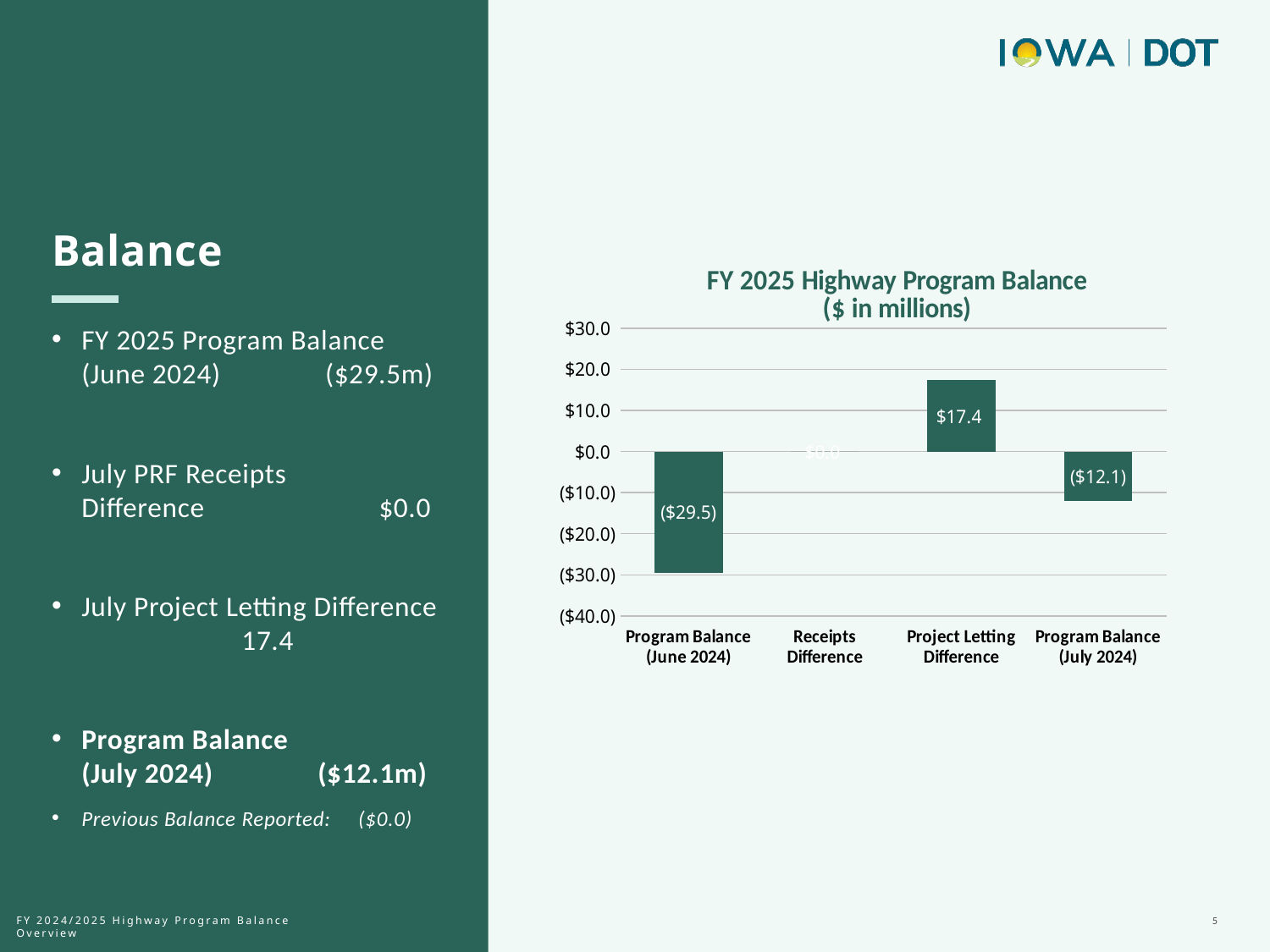
What is the value for Project Letting Difference in the chart? $17.4 Which category has the lowest value in the chart? Program Balance (June 2024) What kind of chart is shown on the slide? bar chart Which is larger, the value for Project Letting Difference or the value for Program Balance (July 2024)? Project Letting Difference Is the value for Program Balance (June 2024) greater or less than ($20.0)? less What is the value for Program Balance (June 2024) in the FY 2025 Highway Program Balance chart? ($29.5) Which category has the highest value in the chart? Project Letting Difference Is the value for Project Letting Difference greater or less than $10.0? greater By how much does the Program Balance (July 2024) exceed the Program Balance (June 2024)? $17.4 How many categories are shown in the chart? 4 What is the title of the chart? FY 2025 Highway Program Balance ($ in millions) What is the value for Program Balance (July 2024) in the chart? ($12.1)